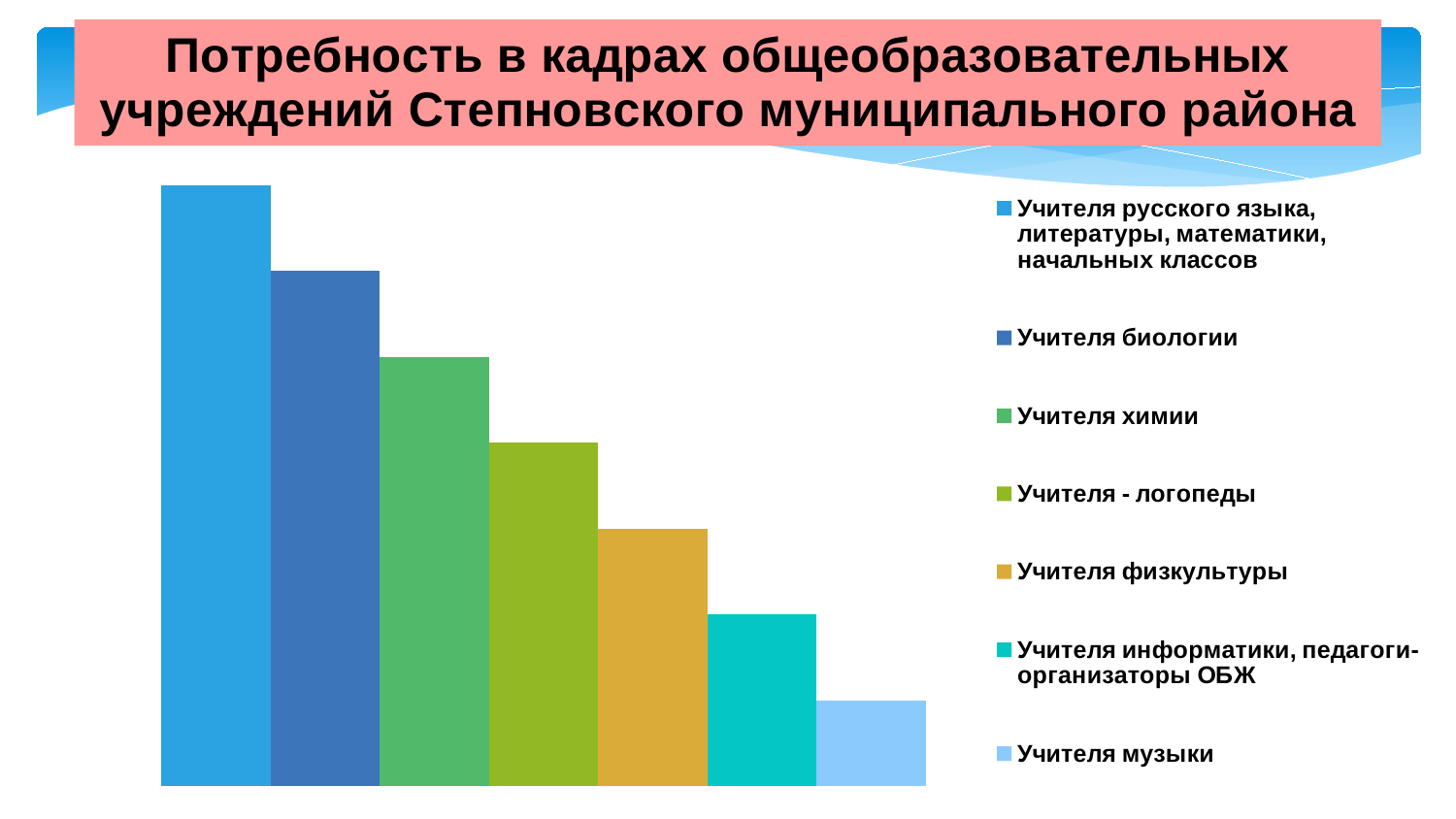
Which is larger: the bar for Учителя физкультуры or the bar for Учителя - логопеды? Учителя - логопеды How many bars are plotted in the chart? 7 Do the bars rise or fall from left to right across the chart? Fall Which legend entry is shown in orange? Учителя физкультуры What is the title of the slide containing the chart? Потребность в кадрах общеобразовательных учреждений Степновского муниципального района How many series does the legend list? 7 Which category has the tallest bar? Учителя русского языка, литературы, математики, начальных классов Which is larger: the bar for Учителя музыки or the bar for Учителя информатики, педагоги-организаторы ОБЖ? Учителя информатики, педагоги-организаторы ОБЖ What kind of chart is shown on the slide? Bar chart Which is larger: the bar for Учителя биологии or the bar for Учителя химии? Учителя биологии Which category has the shortest bar? Учителя музыки